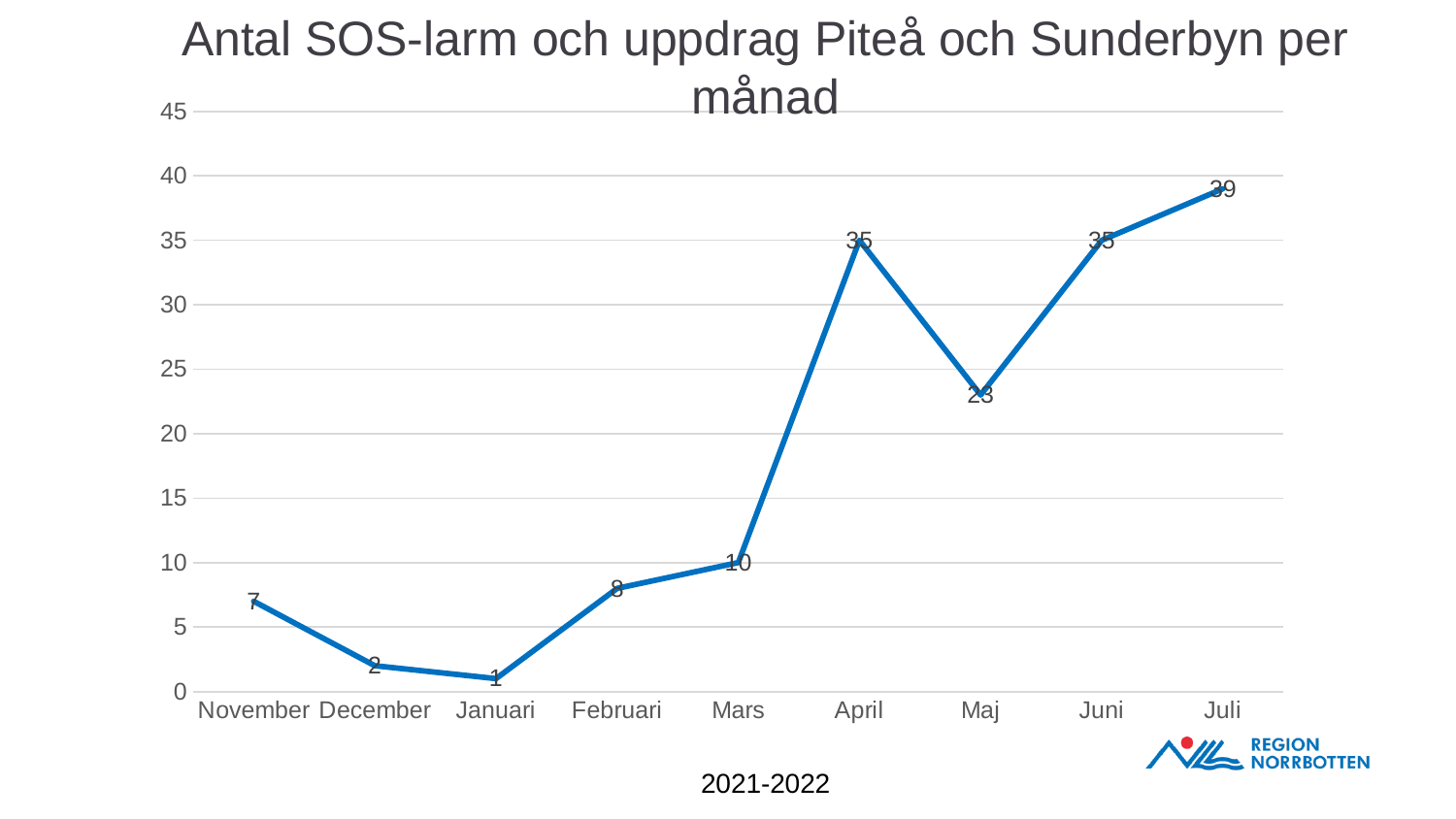
How many months are plotted on the x axis? 9 What is the value for April? 35 What is the difference between the values for Juli and Juni? 4 What is the value for November? 7 Which month has the highest value? Juli Which is larger, the value for Februari or the value for Mars? Mars What kind of chart is shown? line chart What is the difference between the values for April and Maj? 12 What is the title of the chart? Antal SOS-larm och uppdrag Piteå och Sunderbyn per månad Which month has the lowest value? Januari Is the value for Maj greater or less than 20? greater What is the value for Maj? 23